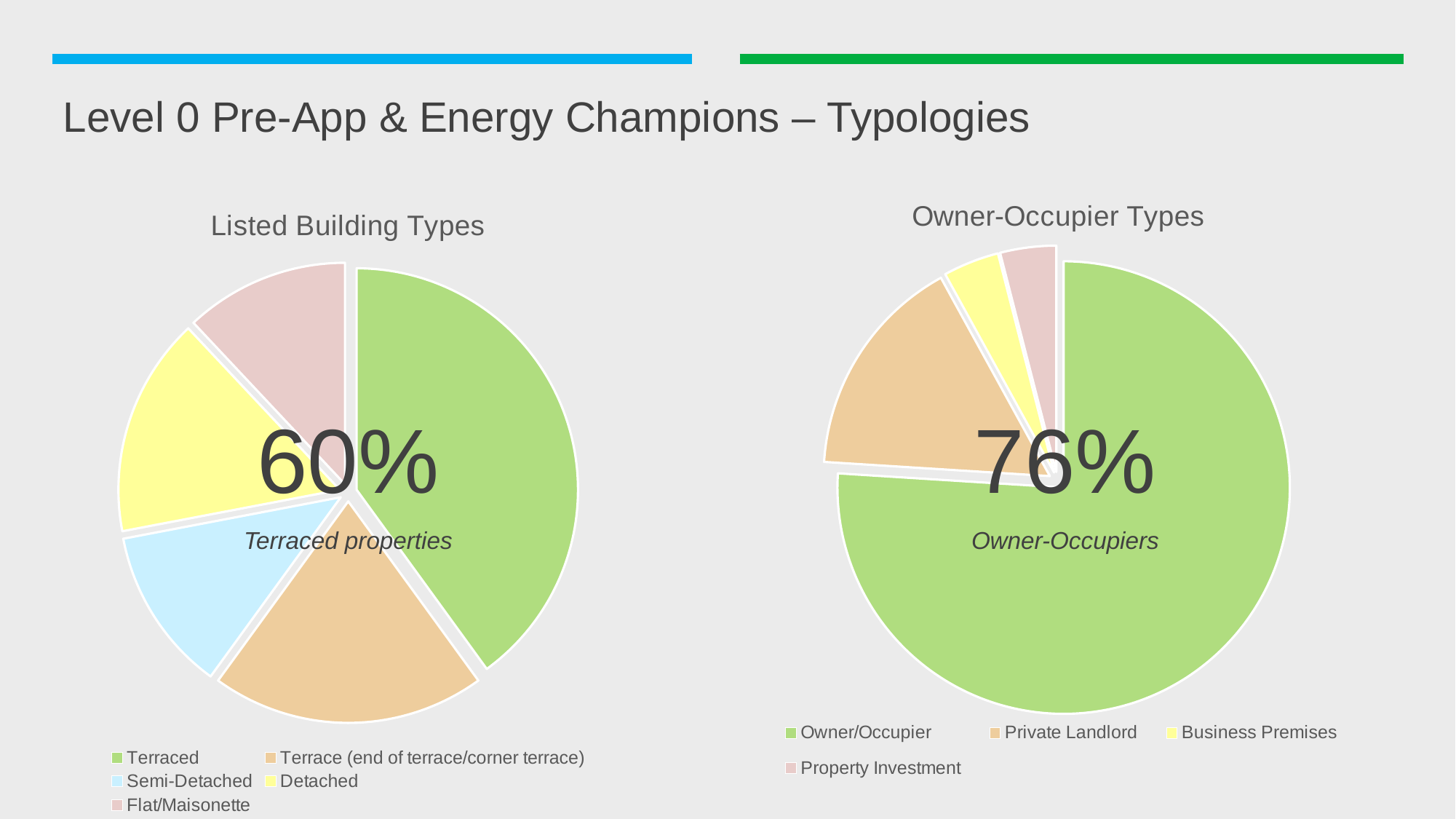
In the Owner-Occupier Types chart, what share of the pie is Owner/Occupier? 76% In the Owner-Occupier Types chart, which category has the largest slice? Owner/Occupier What type of chart is the Owner-Occupier Types chart? pie chart In the Listed Building Types chart, which slice is larger: Terraced or Semi-Detached? Terraced What percentage is printed in the centre of the Listed Building Types chart? 60% In the Listed Building Types chart, which category has the largest slice? Terraced How many categories does the Owner-Occupier Types pie chart have? 4 In the Owner-Occupier Types chart, which slice is larger: Private Landlord or Business Premises? Private Landlord How many categories does the Listed Building Types pie chart have? 5 What colour is the Flat/Maisonette slice in the Listed Building Types chart? pink How many entries does the legend of the Owner-Occupier Types chart list? 4 What type of chart is the Listed Building Types chart? pie chart